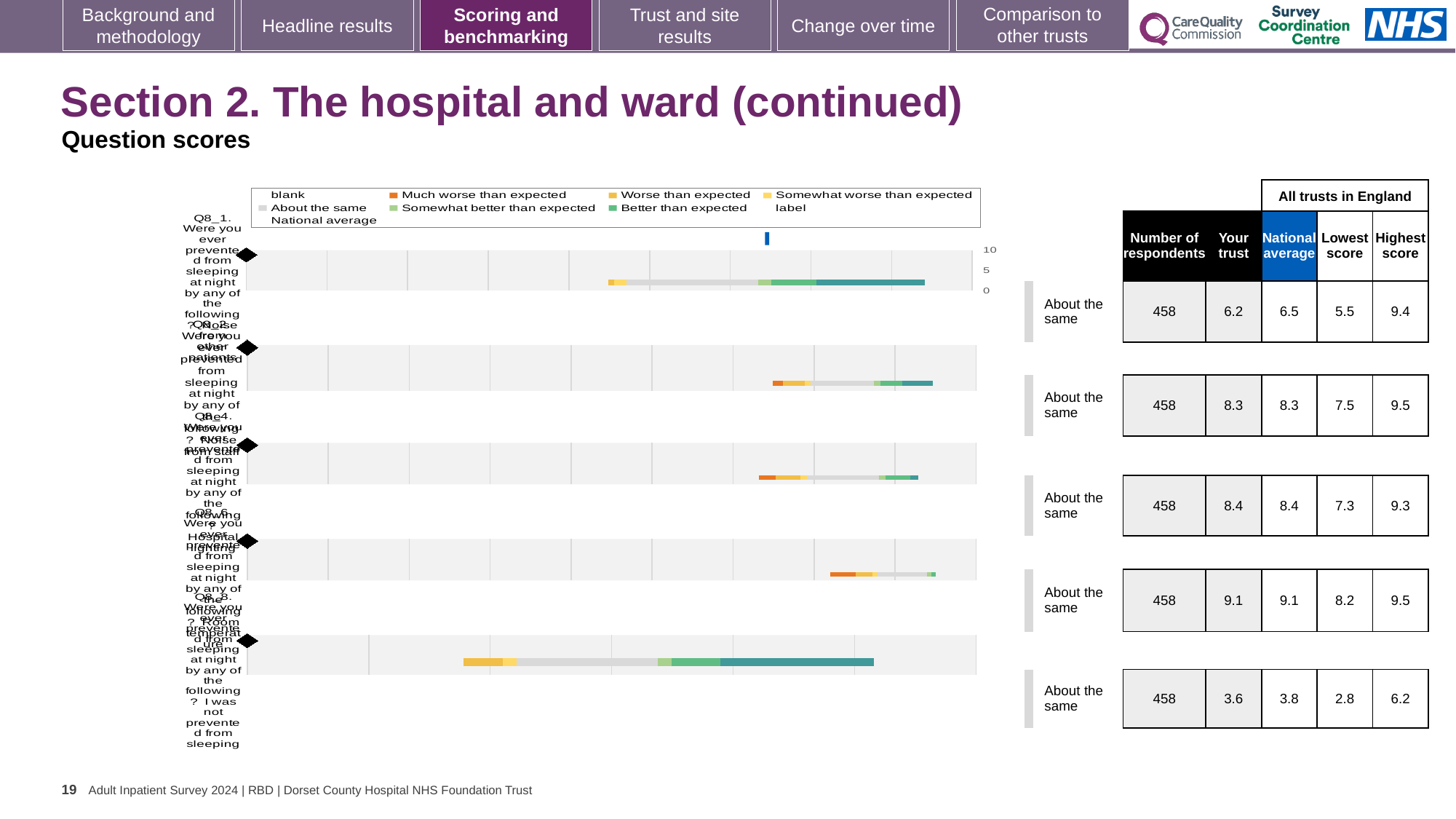
For the first question row, what is the difference between the highest score and the lowest score across all trusts in England? 3.9 Which question row has the highest 'Your trust' score? the fourth row (9.1) What is the highest value shown on the chart's score axis? 10 What colour represents 'About the same' in the chart legend? grey What is the national average for the fifth (bottom) question row? 3.8 What is the 'Your trust' score for the first (top) question row? 6.2 How many respondents are listed for each question row? 458 Is the trust score marker for the fifth (bottom) question row greater or less than 5? less Which question row has the lowest 'Your trust' score? the fifth (bottom) row (3.6) What kind of chart is shown on the slide? bar chart For the first question row, which is larger: the 'Your trust' score or the national average? national average How many question rows (bars) are plotted in the chart? 5